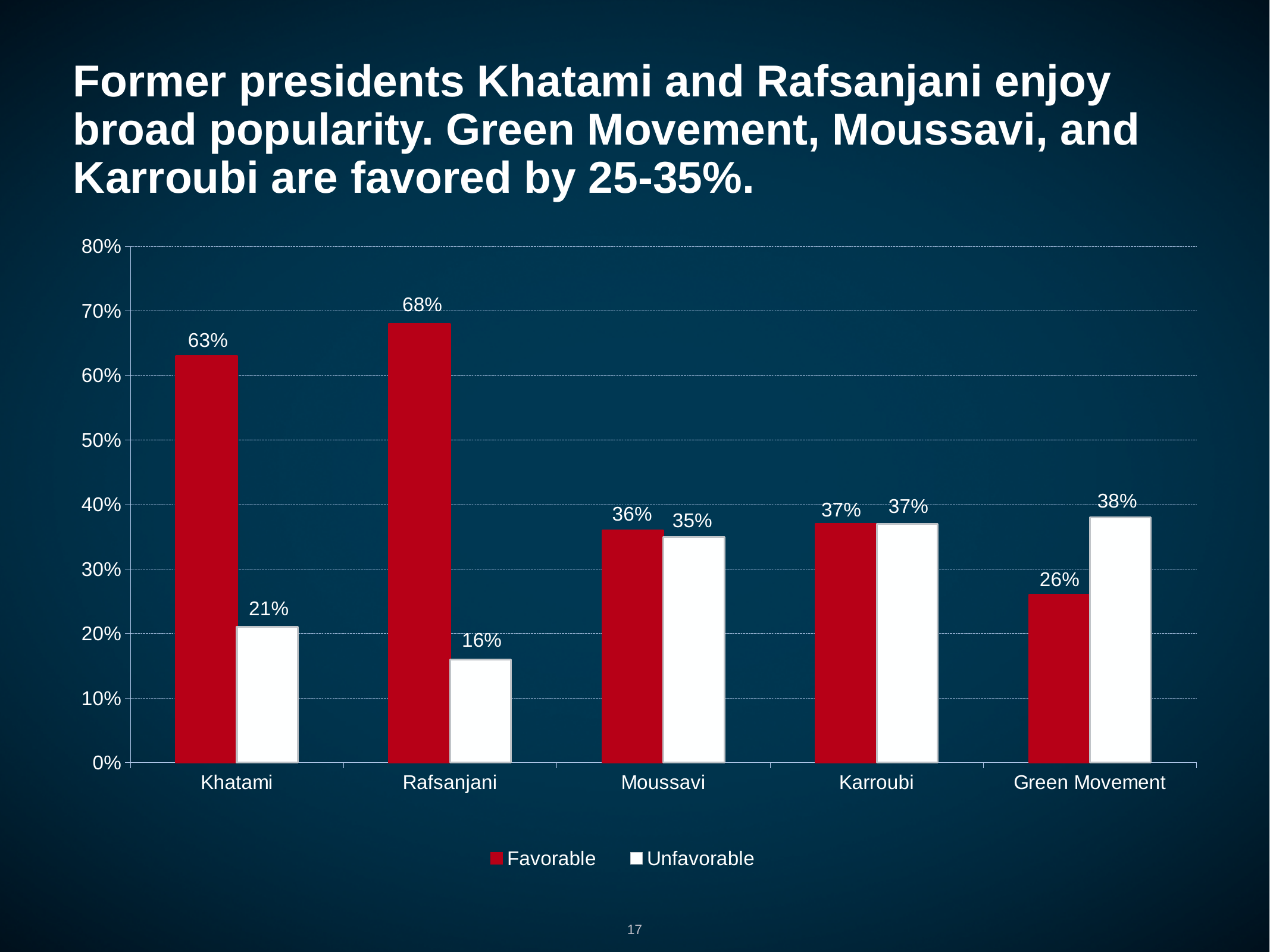
What kind of chart is shown on the slide? Bar chart Which category has the lowest Favorable value? Green Movement What is the Unfavorable value for Green Movement? 38% Which category has the lowest Unfavorable value? Rafsanjani Which is larger for Green Movement, the Favorable value or the Unfavorable value? Unfavorable Which category has the highest Favorable value? Rafsanjani What is the difference between the Favorable values for Rafsanjani and Moussavi? 32% What is the Favorable value for Khatami? 63% How many series does the legend list? 2 What is the difference between the Favorable and Unfavorable values for Khatami? 42% How many categories are shown on the x axis? 5 What is the Unfavorable value for Rafsanjani? 16%